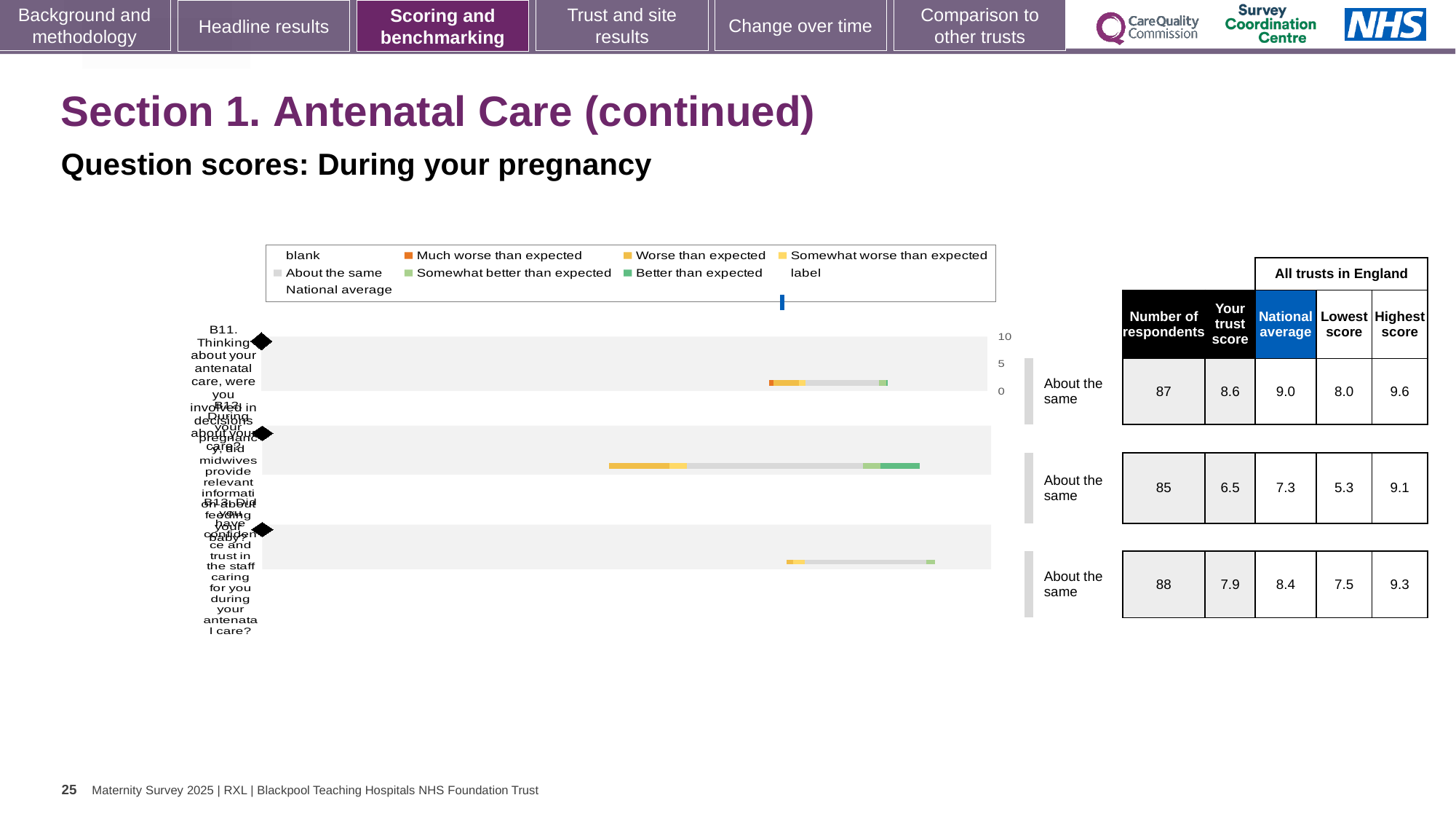
Is the trust score for question B12 greater or less than 5? greater What kind of chart is used to show the question scores on this slide? bar chart Which is larger: the trust score for B11 or the trust score for B13? B11 What is the 'Your trust score' value for question B11? 8.6 Which question has the highest 'Your trust score'? B11 What is the highest score across all trusts in England for question B11? 9.6 What is the national average for question B12? 7.3 How many respondents answered question B13? 88 Which question has the lowest 'Lowest score' across all trusts in England? B12 How many questions (categories) are plotted in the chart? 3 What is the difference between the national average and the trust score for question B12? 0.8 What benchmark category is shown next to each of the three questions? About the same